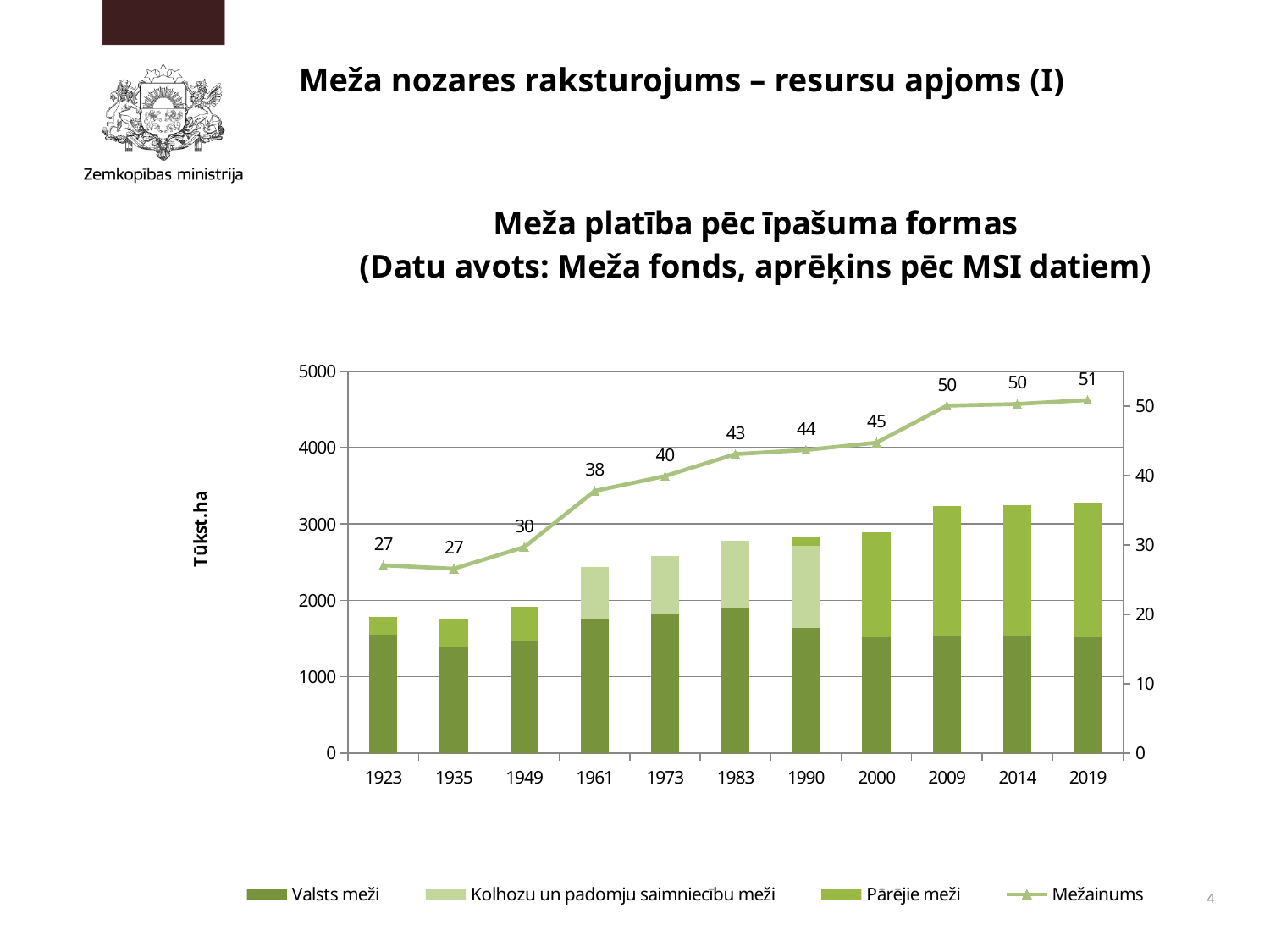
What is the lowest Mežainums value shown on the chart? 27 Is the total stacked bar for 2019 greater or less than 3000? greater Is the Valsts meži value for 1935 greater or less than 1500? less What is the Mežainums value for 2019? 51 In which year is the Mežainums value highest? 2019 What is the difference between the Mežainums values for 2019 and 1923? 24 What is the Mežainums value for 1961? 38 Which year has a larger Mežainums value, 1983 or 2000? 2000 What is the Mežainums value for 1923? 27 How many years are shown on the x axis of the chart? 11 Does the Mežainums line generally rise or fall from 1923 to 2019? rise How many series does the chart legend list? 4